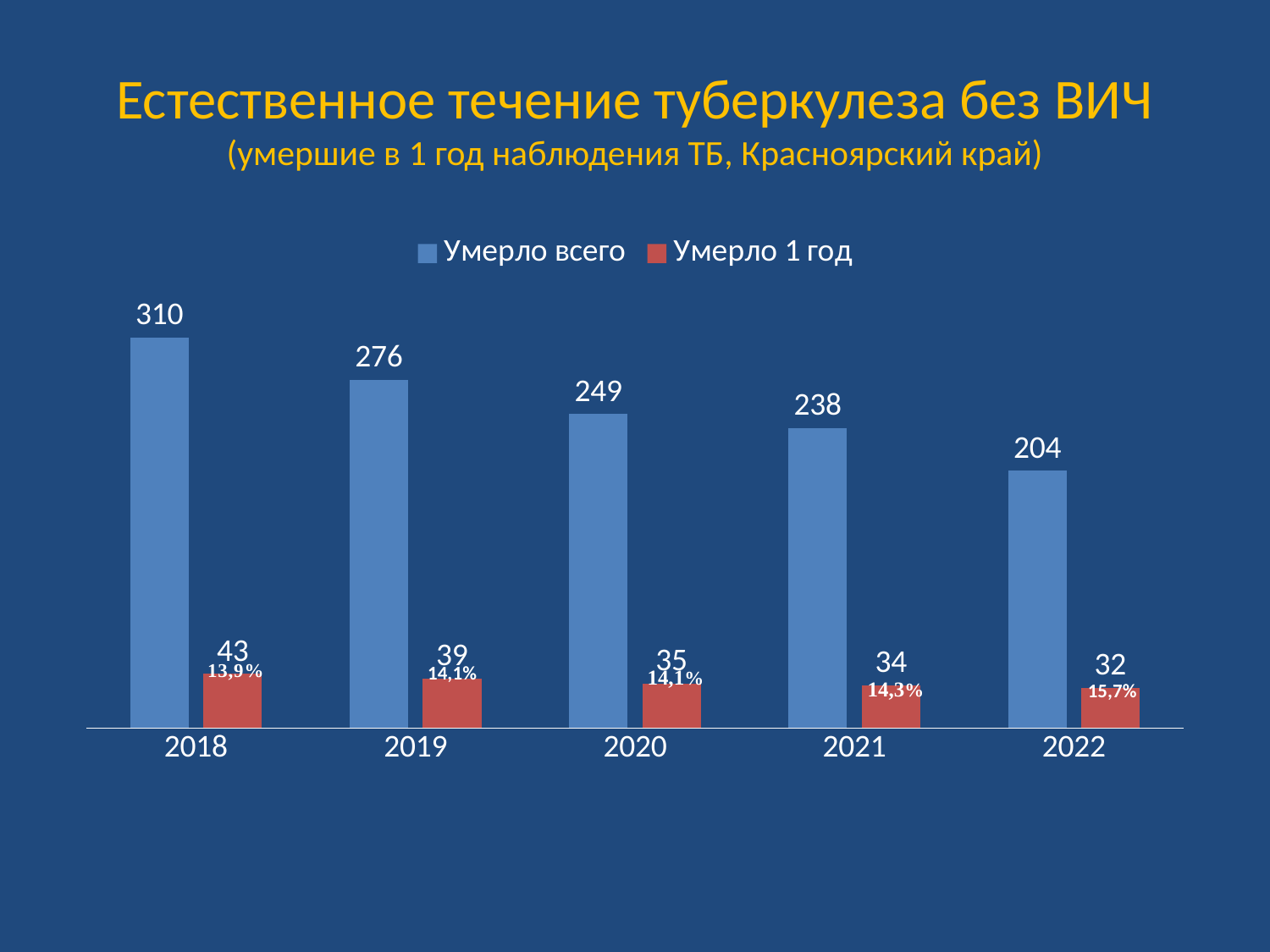
Which year has the highest value for "Умерло всего"? 2018 What is the difference between "Умерло всего" in 2018 and in 2022? 106 Which is larger: "Умерло всего" in 2019 or in 2021? 2019 Do the values for "Умерло всего" rise or fall from 2018 to 2022? fall What is the value of "Умерло 1 год" for 2022? 32 Which year has the lowest value for "Умерло 1 год"? 2022 What is the value of "Умерло всего" for 2018? 310 How many series does the legend list? 2 How many years are shown on the x axis? 5 What is the difference between "Умерло 1 год" in 2018 and in 2019? 4 What is the value of "Умерло всего" for 2020? 249 What kind of chart is shown on the slide? bar chart